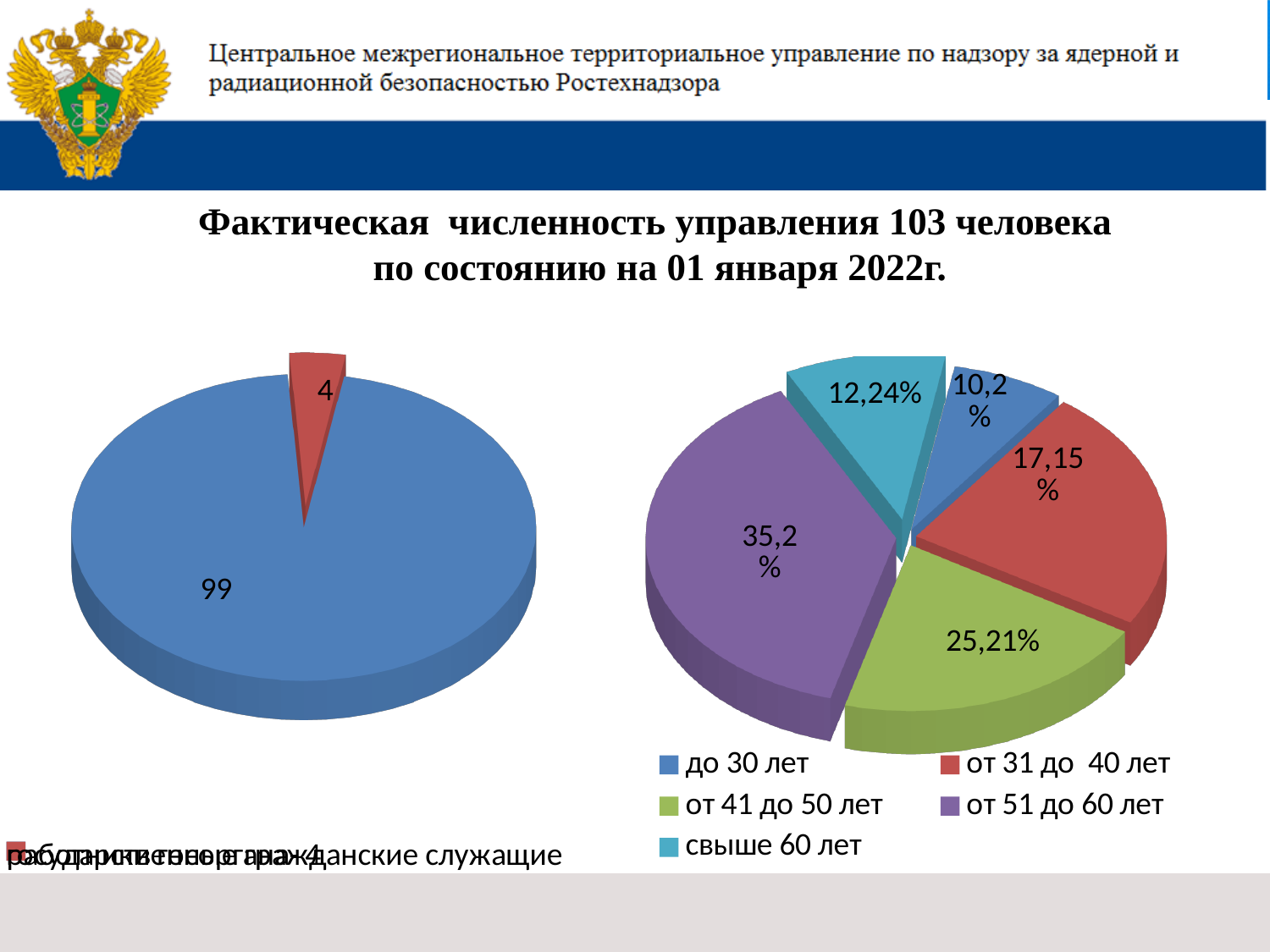
In the left pie chart, what is the difference between the two slice values? 95 What kind of chart is the chart on the right of the slide? pie chart In the right pie chart, what is the share for the category 'свыше 60 лет'? 12,24% In the right pie chart, what is the share for the category 'от 41 до 50 лет'? 25,21% In the left pie chart, what value is shown on the small red slice? 4 In the right pie chart, which age category has the smallest share? до 30 лет In the right pie chart, what is the difference between the shares for 'от 51 до 60 лет' and 'от 41 до 50 лет'? 9,99% In the right pie chart, which is larger: the share for 'от 31 до 40 лет' or for 'свыше 60 лет'? от 31 до 40 лет How many age categories does the legend of the right pie chart list? 5 In the right pie chart, which age category has the largest share? от 51 до 60 лет In the left pie chart, what value is shown on the large blue slice? 99 In the right pie chart, what is the share for the category 'до 30 лет'? 10,2%